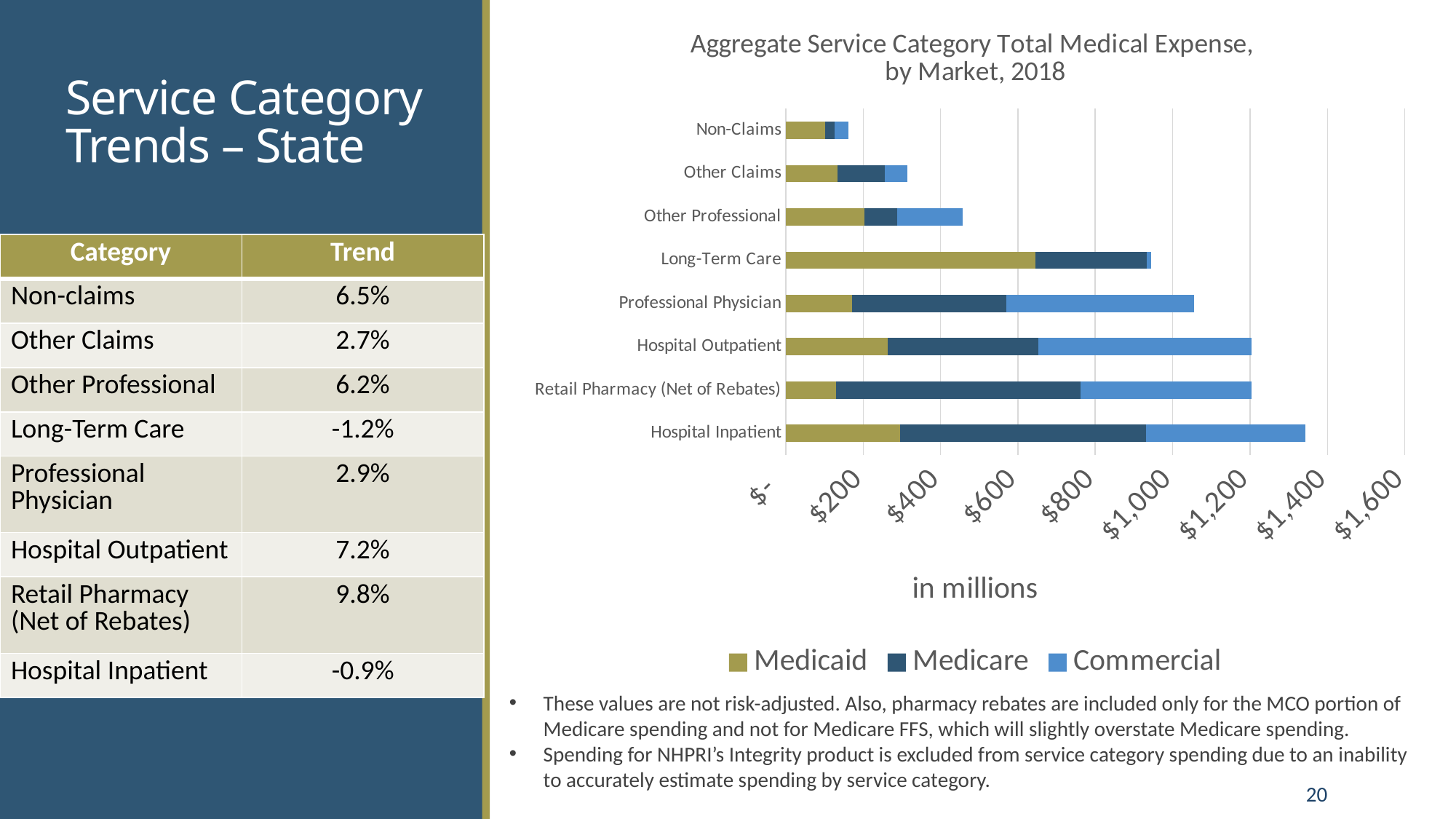
Is the total value for Non-Claims greater or less than $200? less Is the total value for Long-Term Care greater or less than $800? greater What kind of chart is shown on the slide? Stacked bar chart Which service category has the lowest total medical expense in the chart? Non-Claims Is the total value for Hospital Inpatient greater or less than $1,200? greater How many service categories are plotted in the chart? 8 How many series does the chart legend list? 3 Which has the larger total medical expense, Long-Term Care or Other Professional? Long-Term Care Which service category has the highest total medical expense in the chart? Hospital Inpatient Which category has the larger Medicaid segment, Long-Term Care or Hospital Inpatient? Long-Term Care What is the title of the chart? Aggregate Service Category Total Medical Expense, by Market, 2018